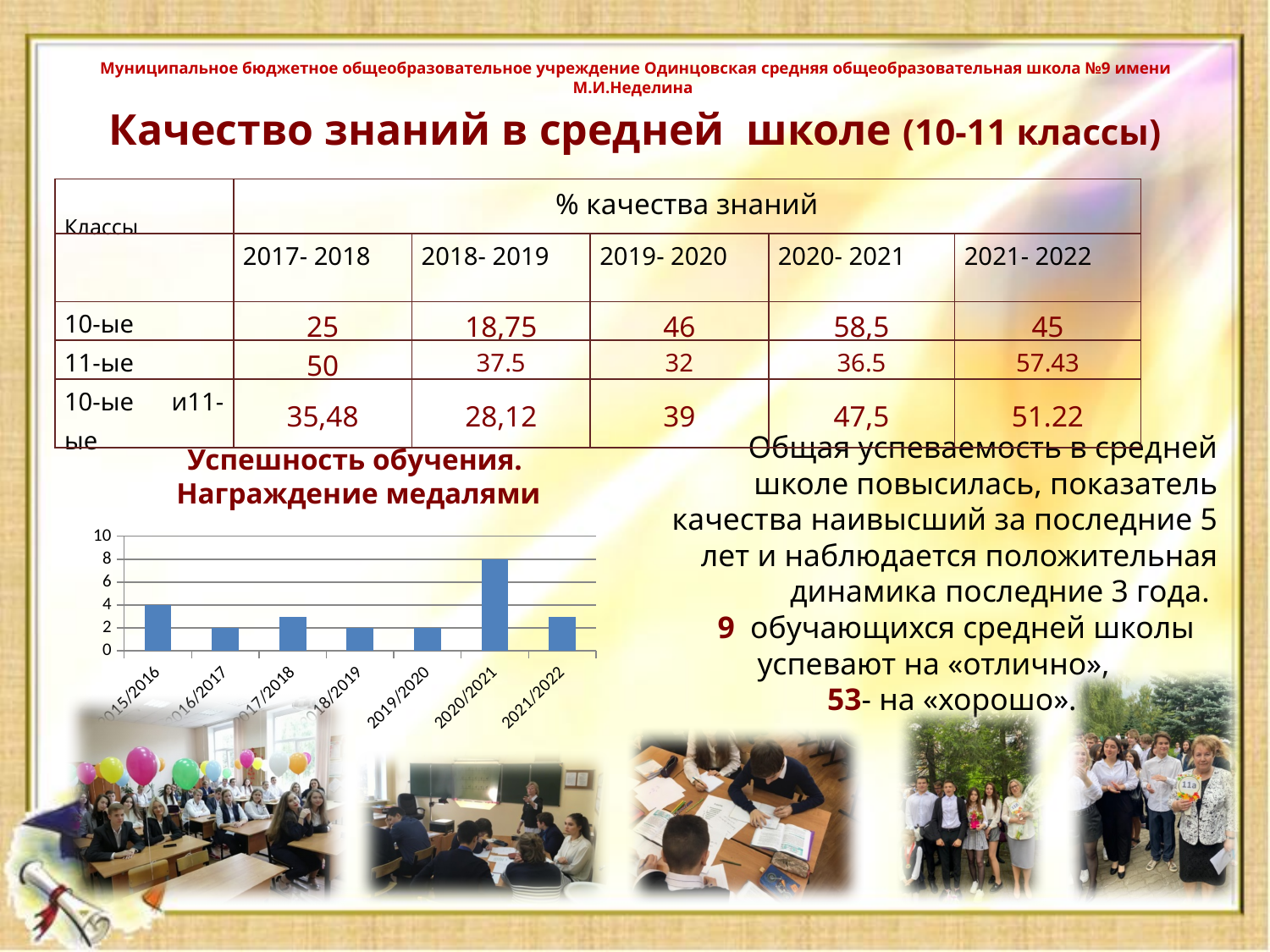
What is the value for 2019/2020 in the bar chart? 2 Is the value for 2017/2018 in the bar chart greater or less than 2? greater Is the value for 2021/2022 in the bar chart greater or less than 4? less What is the value for 2016/2017 in the bar chart? 2 What is the value for 2020/2021 in the bar chart? 8 What is the value for 2015/2016 in the bar chart? 4 Which school year has the highest bar in the chart? 2020/2021 How many categories (school years) are shown on the x axis of the bar chart? 7 What type of chart is shown under the heading "Успешность обучения. Награждение медалями"? bar chart Which is larger in the bar chart, the value for 2020/2021 or the value for 2015/2016? 2020/2021 What is the title shown above the bar chart? Успешность обучения. Награждение медалями What is the difference between the values for 2020/2021 and 2015/2016 in the bar chart? 4